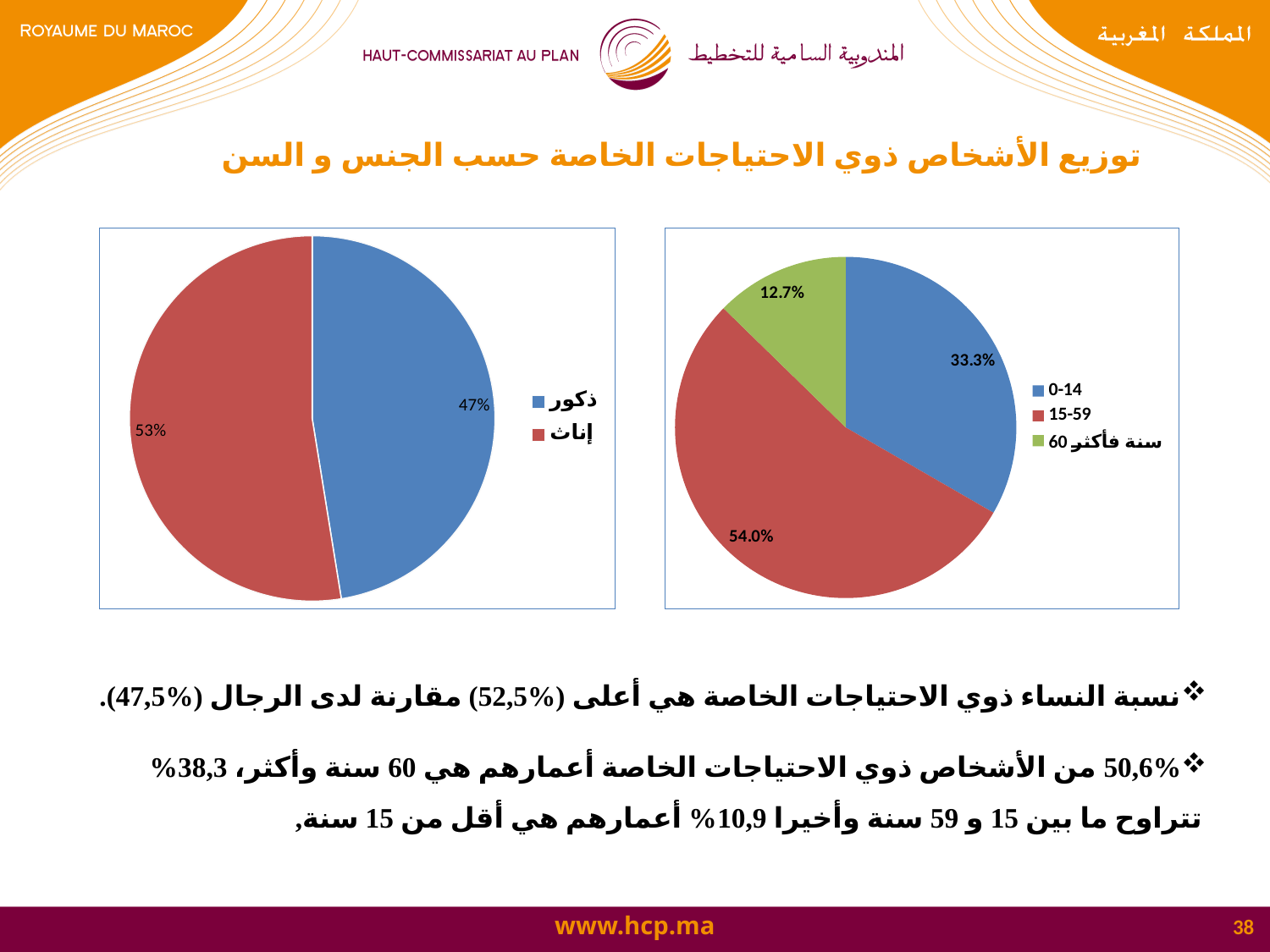
In the right pie chart, what share is shown for 60 سنة فأكثر? 12.7% In the left pie chart, what share is shown for إناث? 53% In the right pie chart, what share is shown for the 15-59 age group? 54.0% In the right pie chart, what share is shown for the 0-14 age group? 33.3% In the right pie chart, which age group has the largest share? 15-59 How many slices does the right pie chart have? 3 In the left pie chart, which category has the larger share, ذكور or إناث? إناث In the right pie chart, which age group has the smallest share? 60 سنة فأكثر In the left pie chart, what share is shown for ذكور? 47% How many entries does the legend of the left pie chart list? 2 What kind of chart is the left chart on the slide? pie chart In the left pie chart, what is the difference between the shares of إناث and ذكور? 6%